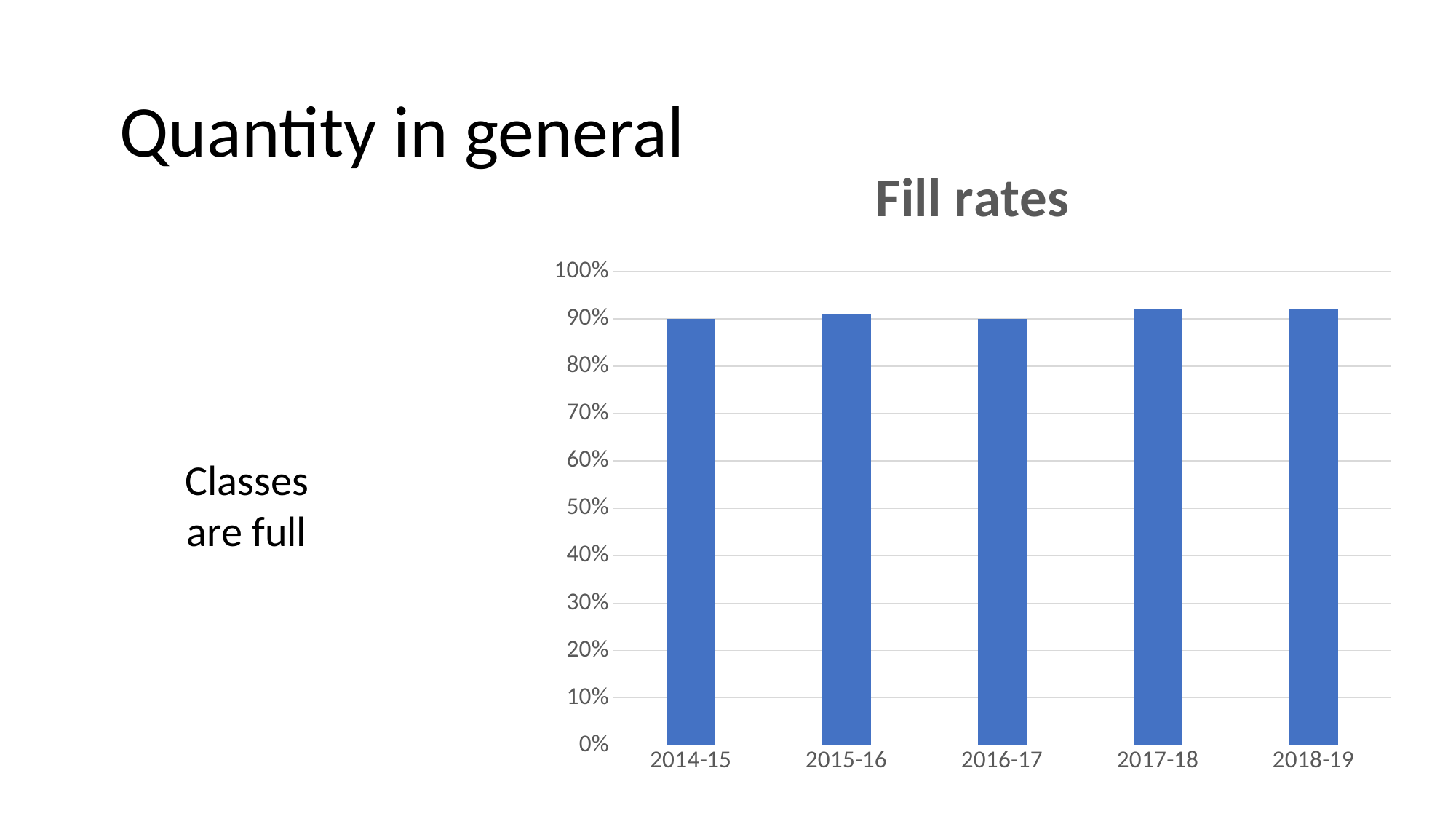
Is the fill rate for 2015-16 greater or less than 100%? less Is the fill rate for 2014-15 greater or less than 80%? greater Is the fill rate for 2017-18 greater or less than 100%? less How many academic years are shown on the x axis of the Fill rates chart? 5 What kind of chart is shown on the slide? bar chart What is the highest value shown on the y axis of the Fill rates chart? 100% What is the title of the chart? Fill rates What is the first academic year shown on the x axis of the Fill rates chart? 2014-15